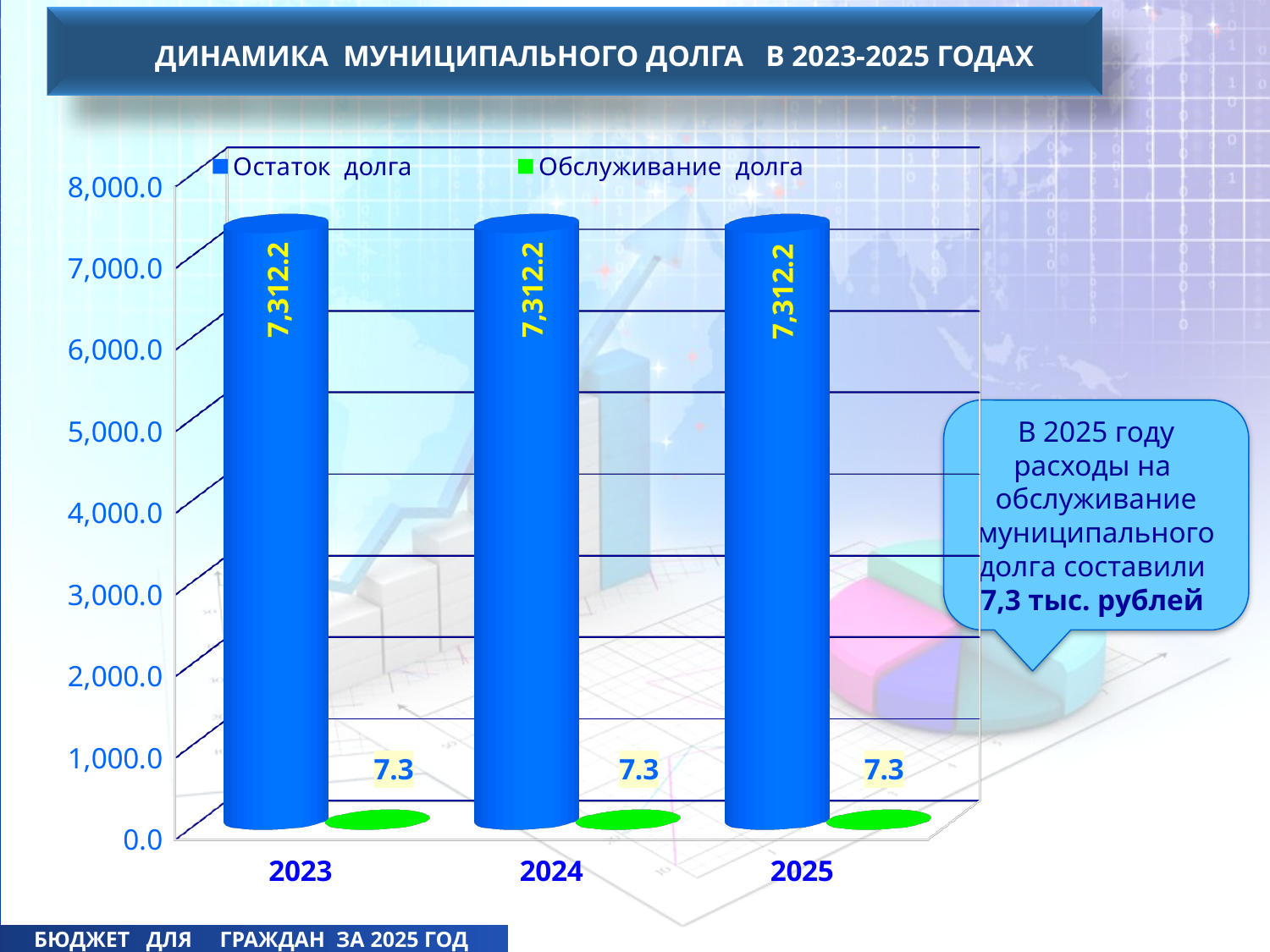
Which series has the larger value in 2024, Остаток долга or Обслуживание долга? Остаток долга What is the value of Остаток долга for 2023? 7,312.2 What is the value of Остаток долга for 2025? 7,312.2 Does the value of Остаток долга rise, fall or stay the same from 2023 to 2025? Stays the same What kind of chart is shown on the slide? Bar chart What is the difference between Остаток долга and Обслуживание долга in 2025? 7,304.9 Is the value of Остаток долга for 2024 greater or less than 7,000.0? greater What is the value of Обслуживание долга for 2024? 7.3 How many series does the chart legend list? 2 What is the value of Обслуживание долга for 2025? 7.3 Is the value of Обслуживание долга for 2023 greater or less than 1,000.0? less How many years are shown on the x axis of the chart? 3